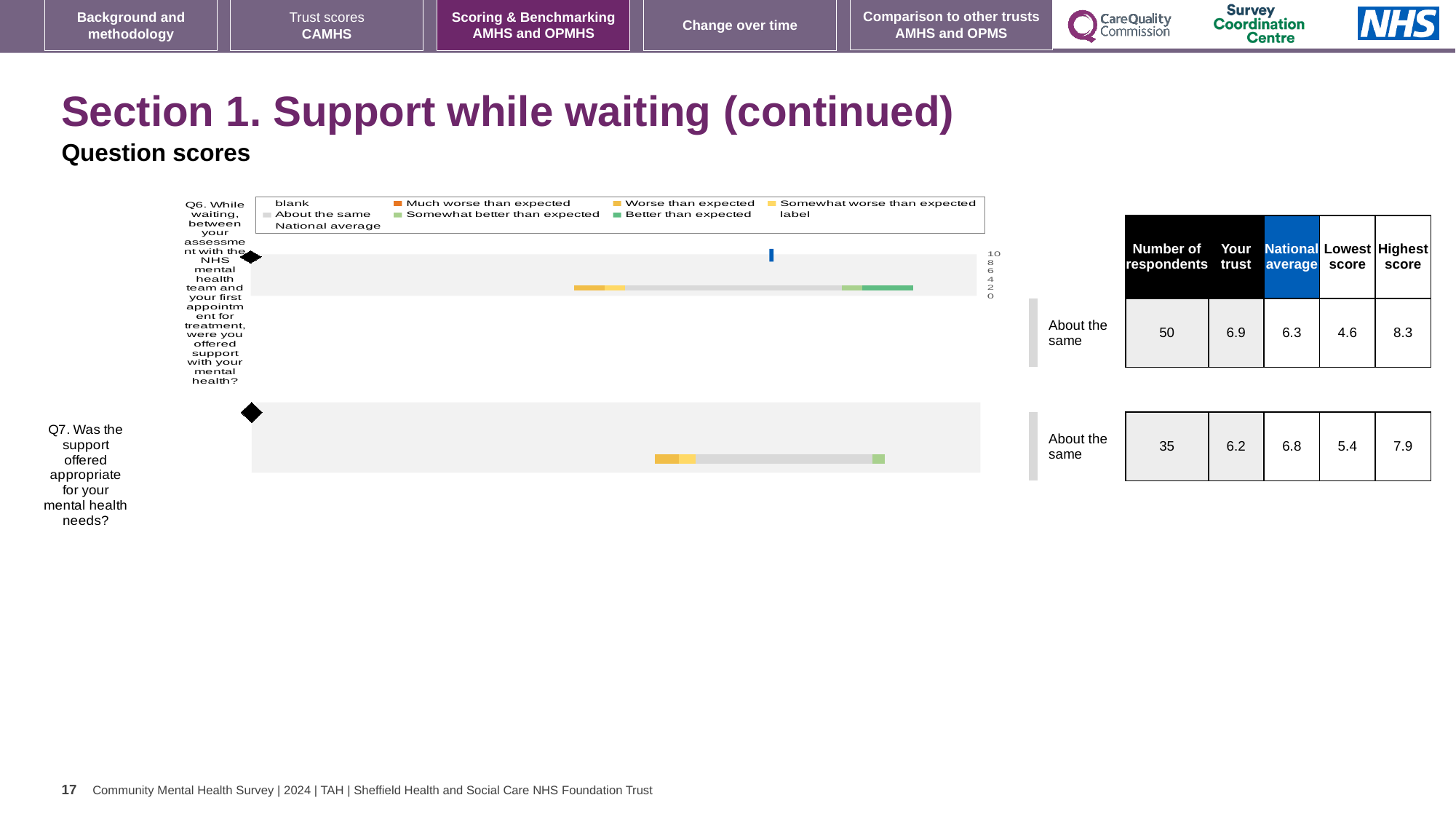
For Q7, which is higher: the 'Your trust' score or the national average? National average According to the table beside the Q7 chart, what is the 'Your trust' score for Q7? 6.2 What kind of chart is used to show the question scores for Q6 and Q7? Bar chart According to the table beside the Q6 chart, what is the 'Your trust' score for Q6? 6.9 According to the table beside the Q7 chart, how many respondents answered Q7? 35 According to the table beside the Q6 chart, what is the national average score for Q6? 6.3 What is the difference between the 'Your trust' score and the national average for Q6? 0.6 For Q6, which is higher: the 'Your trust' score or the national average? Your trust Which legend entry is shown with a dark green colour? Better than expected What benchmark category label is shown next to both the Q6 and Q7 charts? About the same How many questions (categories) are plotted on the slide? 2 What is the difference between the highest score (8.3) and the lowest score (4.6) shown for Q6? 3.7